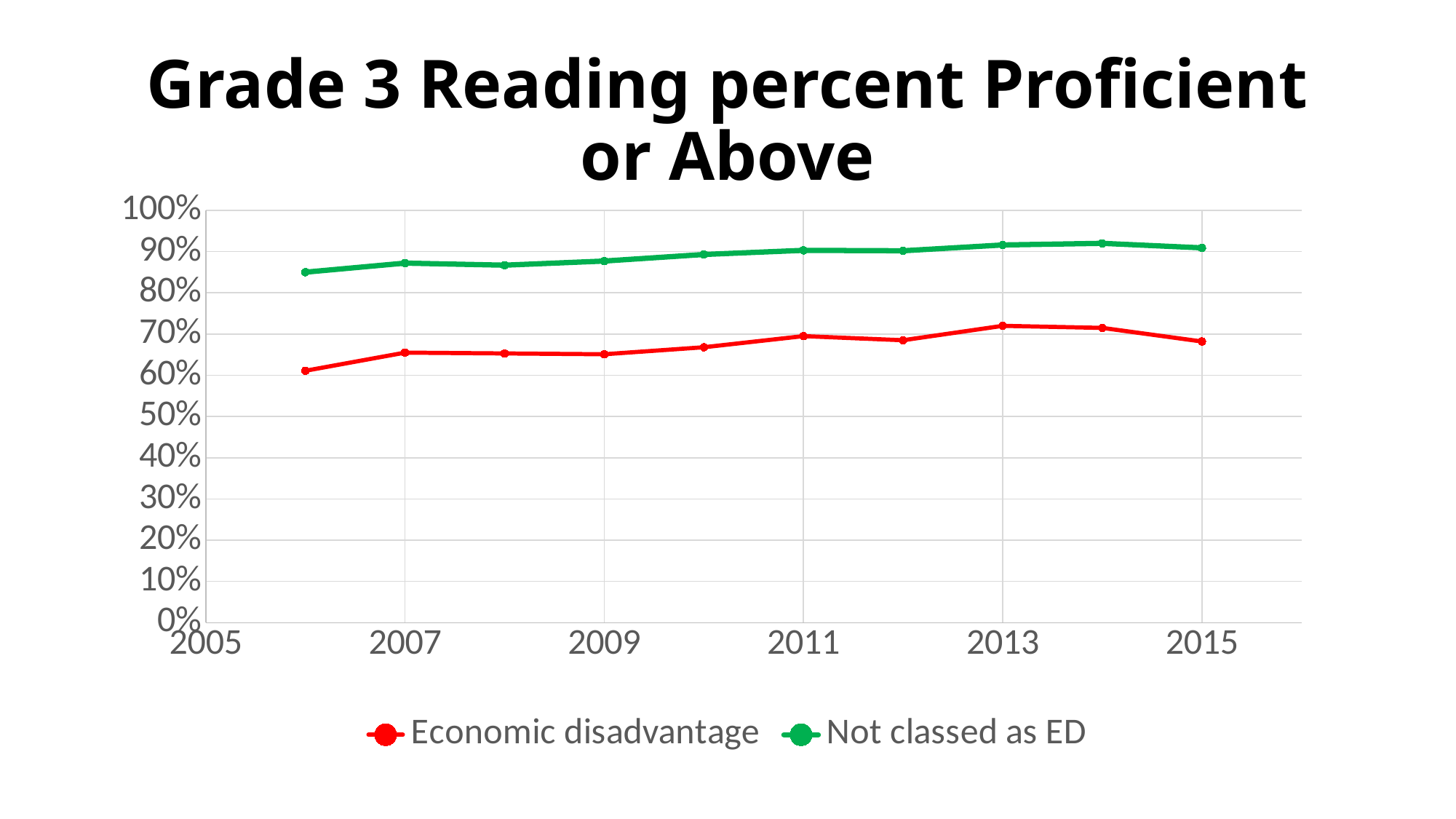
Is the value for Not classed as ED in 2014 greater or less than 90%? greater What kind of chart is shown on the slide? line chart Is the value for Not classed as ED in 2006 greater or less than 90%? less In 2011, which series has the larger value, Economic disadvantage or Not classed as ED? Not classed as ED How many series does the legend list? 2 Which year has the lowest value for Economic disadvantage? 2006 What colour is the line for Economic disadvantage? red Is the value for Economic disadvantage in 2013 greater or less than 70%? greater Which year has the lowest value for Not classed as ED? 2006 How many data points does the Economic disadvantage line have? 10 Does the Not classed as ED line generally rise or fall from 2006 to 2014? rise